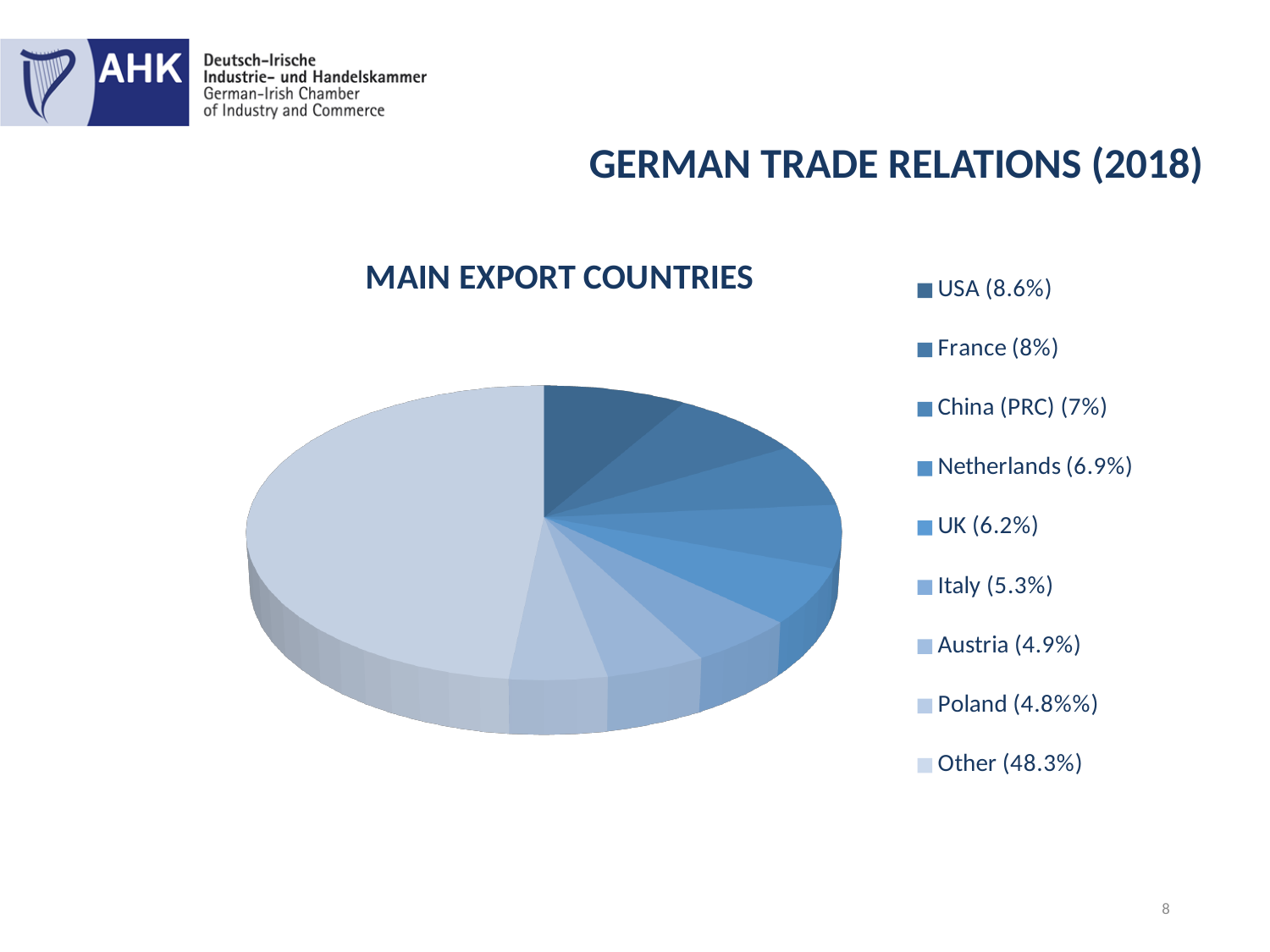
Which named country has the smallest share in the chart? Poland How many categories does the legend list? 9 What kind of chart is shown on the slide? Pie chart What share of exports does the legend give for Italy? 5.3% What is the difference in percentage points between the Netherlands' share and the UK's share? 0.7 What share of exports does the legend give for the USA? 8.6% What is the difference in percentage points between the USA's share and France's share? 0.6 What share of exports does the legend give for France? 8% Which category has the largest slice of the pie? Other (48.3%) What share of exports does the legend give for the Netherlands? 6.9% Which has the larger share, China (PRC) or the UK? China (PRC) What is the title of the chart? MAIN EXPORT COUNTRIES